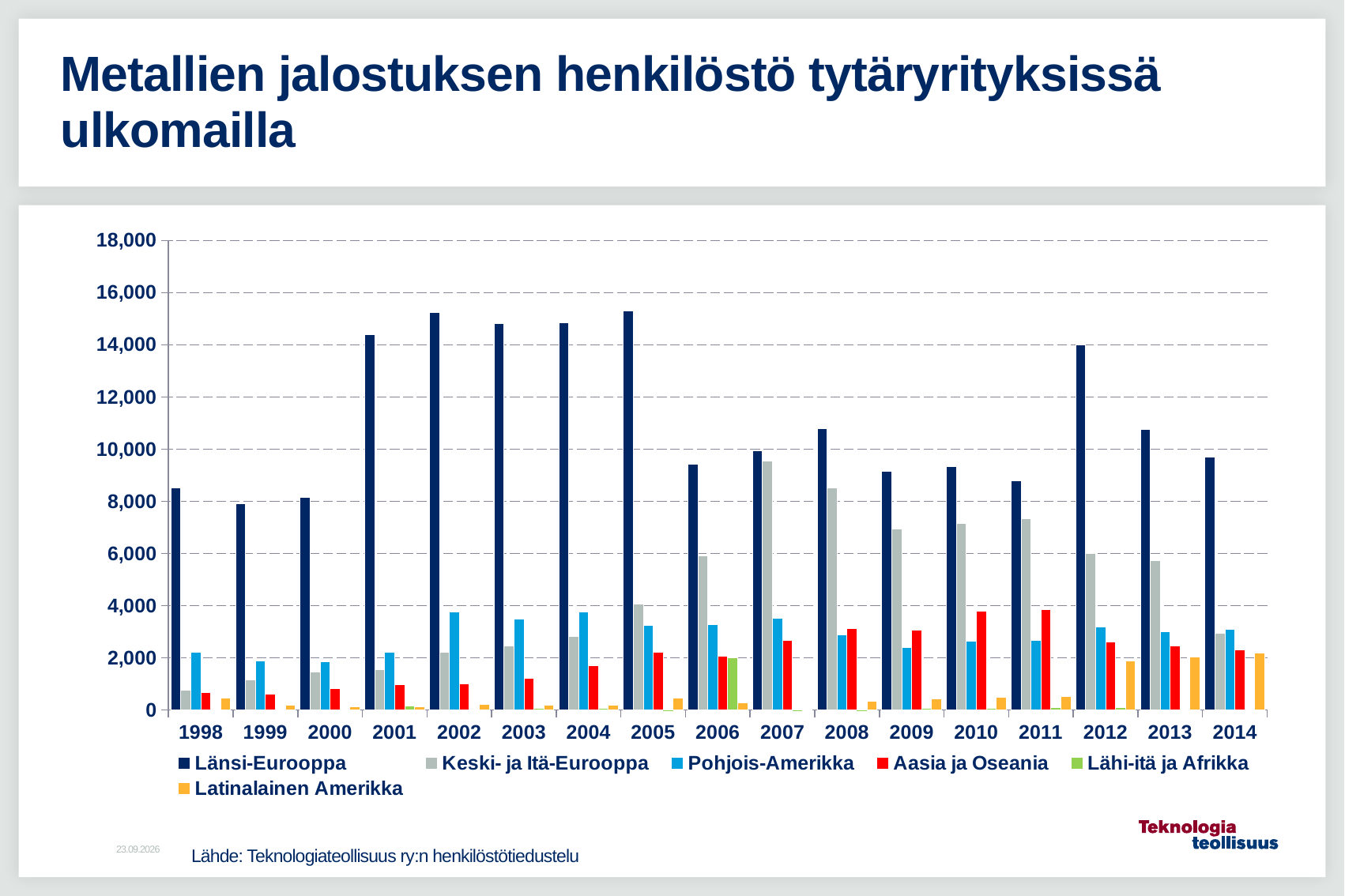
Is the value for Länsi-Eurooppa in 2002 greater or less than 14,000? greater Which is larger: the value for Länsi-Eurooppa in 2001 or in 1998? 2001 What kind of chart is shown on the slide? bar chart What colour represents Aasia ja Oseania in the legend? red In which year is the value for Keski- ja Itä-Eurooppa lowest? 1998 In which year is the value for Keski- ja Itä-Eurooppa highest? 2007 How many series does the legend list? 6 Is the value for Pohjois-Amerikka in 2002 greater or less than 4,000? less Does the value for Keski- ja Itä-Eurooppa rise or fall from 1998 to 2007? rise Is the value for Keski- ja Itä-Eurooppa in 2007 greater or less than 8,000? greater How many years are shown on the x axis? 17